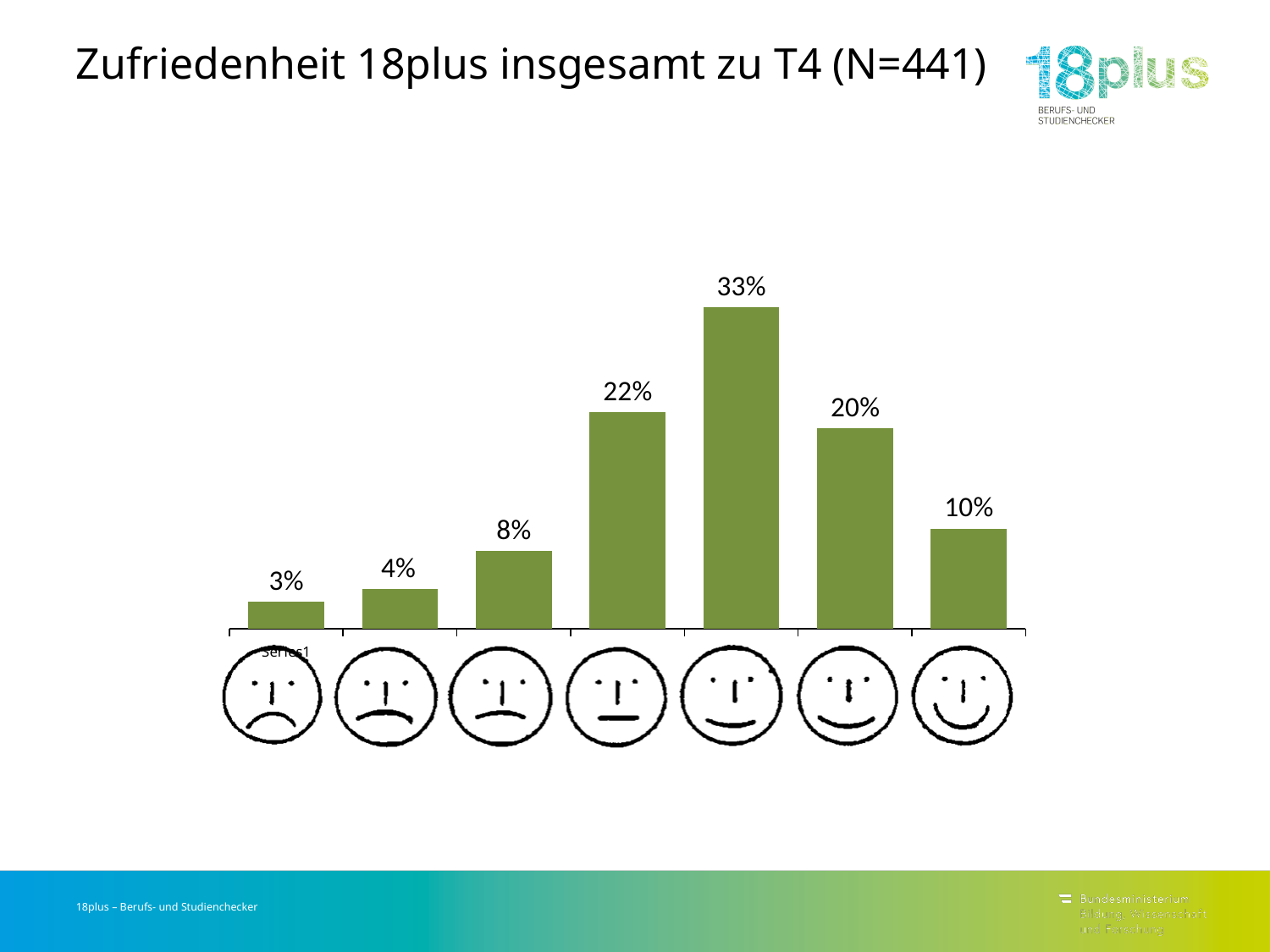
Which is larger: the value of the second bar from the left or the value of the third bar from the left? the third bar (8%) What is the value shown on the shortest bar in the chart? 3% What is the value of the leftmost bar (above the saddest face)? 3% What is the value of the fourth bar from the left (above the neutral face)? 22% What is the title of the slide containing the chart? Zufriedenheit 18plus insgesamt zu T4 (N=441) How many bars are plotted in the chart? 7 What is the difference between the tallest bar (33%) and the fourth bar (22%)? 11% What is the value of the sixth bar from the left? 20% What is the sum of the values of the two leftmost bars (3% and 4%)? 7% What kind of chart is shown on the slide? bar chart What is the value of the rightmost bar (above the happiest face)? 10% What is the value shown on the tallest bar in the chart? 33%